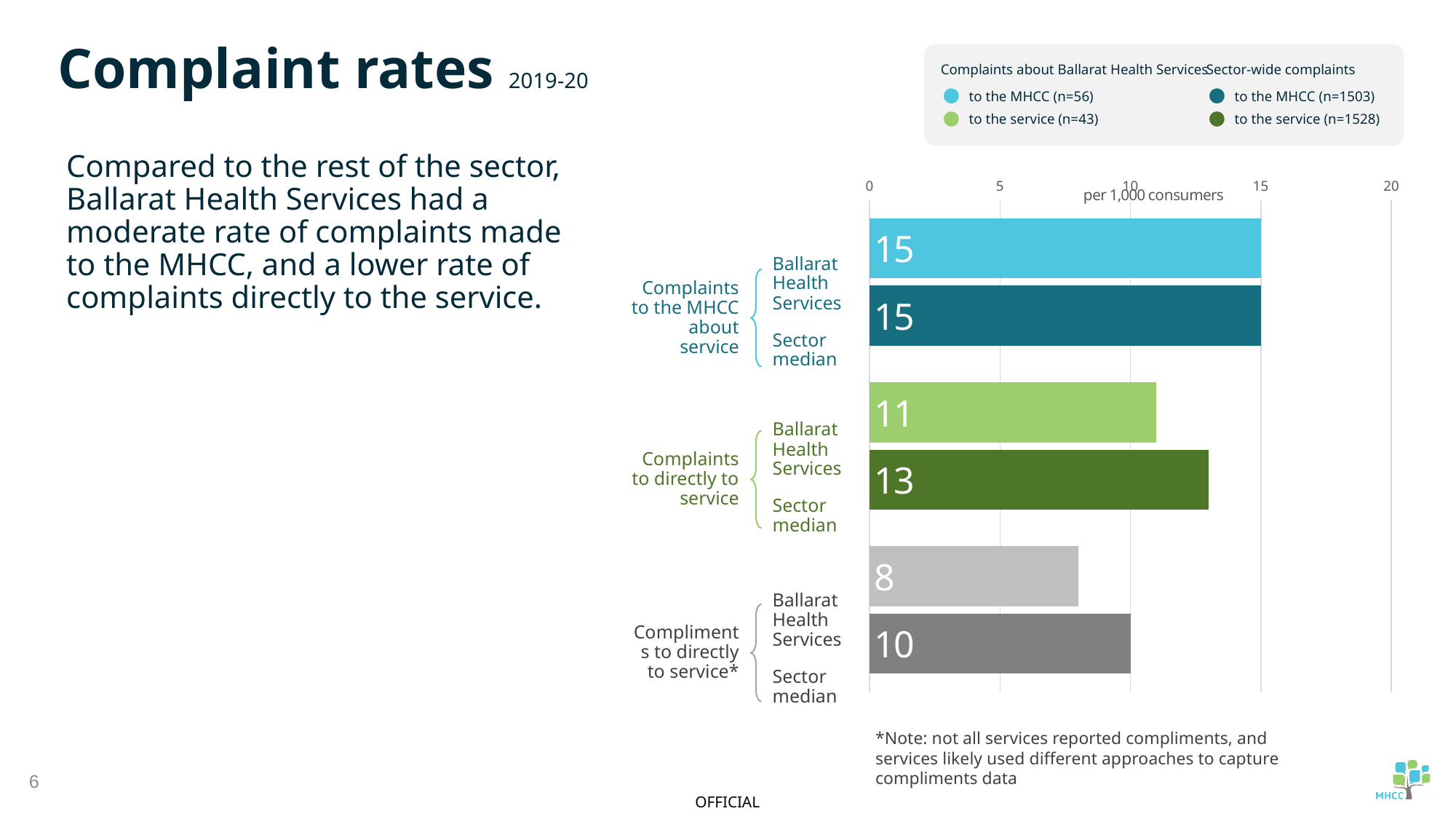
What is the rate of complaints to the MHCC about service for Ballarat Health Services? 15 Which bar in the chart has the lowest value? Ballarat Health Services, compliments directly to service What is the rate of compliments made directly to service for Ballarat Health Services? 8 How many bars are plotted in the chart? 6 Which is larger for complaints made directly to service: Ballarat Health Services or the sector median? Sector median How many entries does the legend list? 4 What is the sector median rate of compliments made directly to service? 10 What is the sector median rate of complaints made directly to service? 13 Is the Ballarat Health Services rate of complaints to the MHCC greater or less than 10? greater What unit is shown on the chart's axis? per 1,000 consumers What is the difference between the sector median and Ballarat Health Services for complaints made directly to service? 2 What kind of chart is shown on the slide? Bar chart